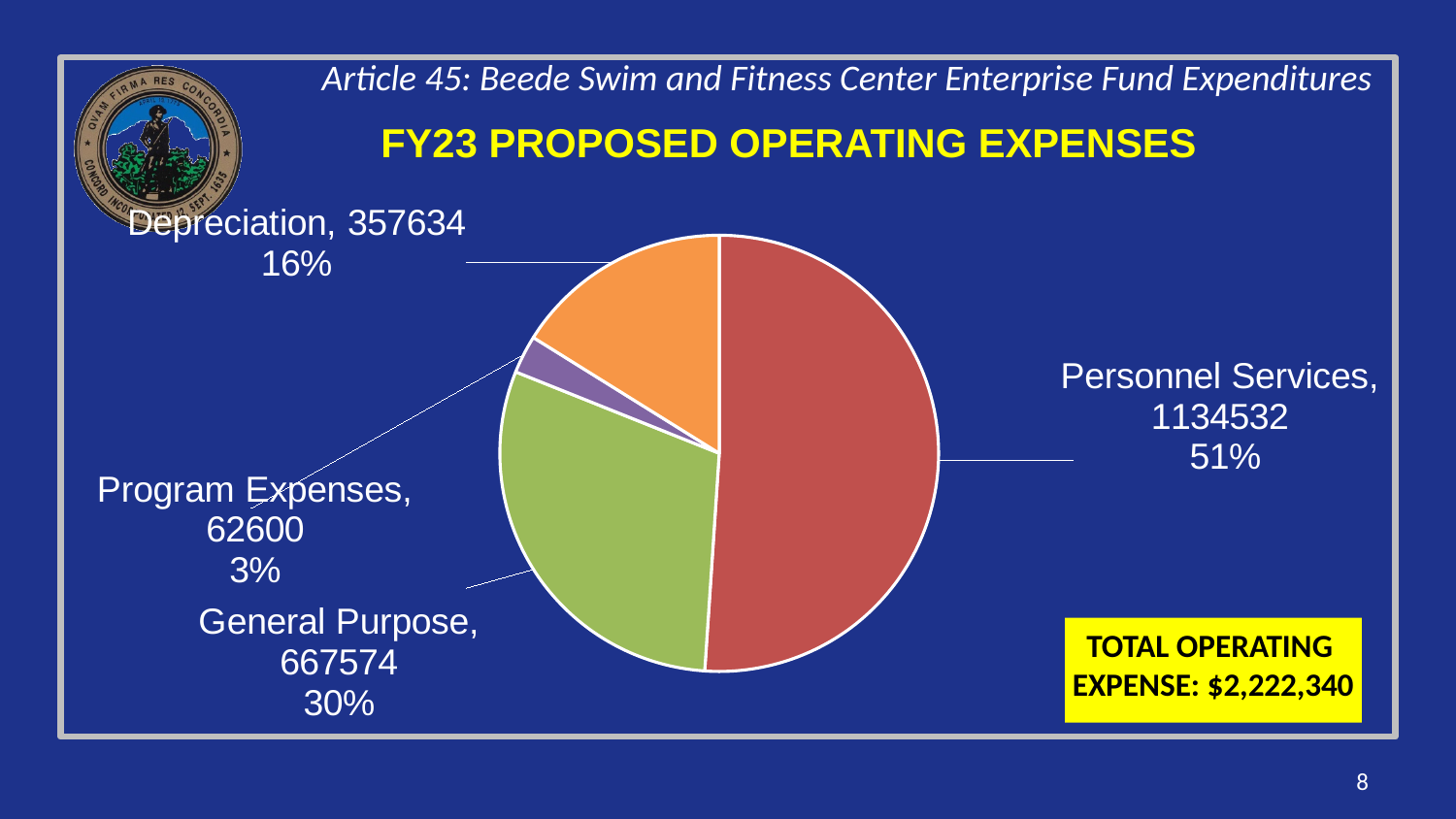
What is the value for Personnel Services? 1134532 What type of chart is shown on the slide? pie chart What is the value for Depreciation? 357634 How many categories are shown in the pie chart? 4 What is the difference between the values for Personnel Services and General Purpose? 466958 Which is larger, the value for Depreciation or the value for Program Expenses? Depreciation What is the value for General Purpose? 667574 What is the value for Program Expenses? 62600 What percentage share of the pie does Depreciation represent? 16% Which category has the largest share of the pie? Personnel Services What percentage share of the pie does General Purpose represent? 30% Which category has the smallest share of the pie? Program Expenses